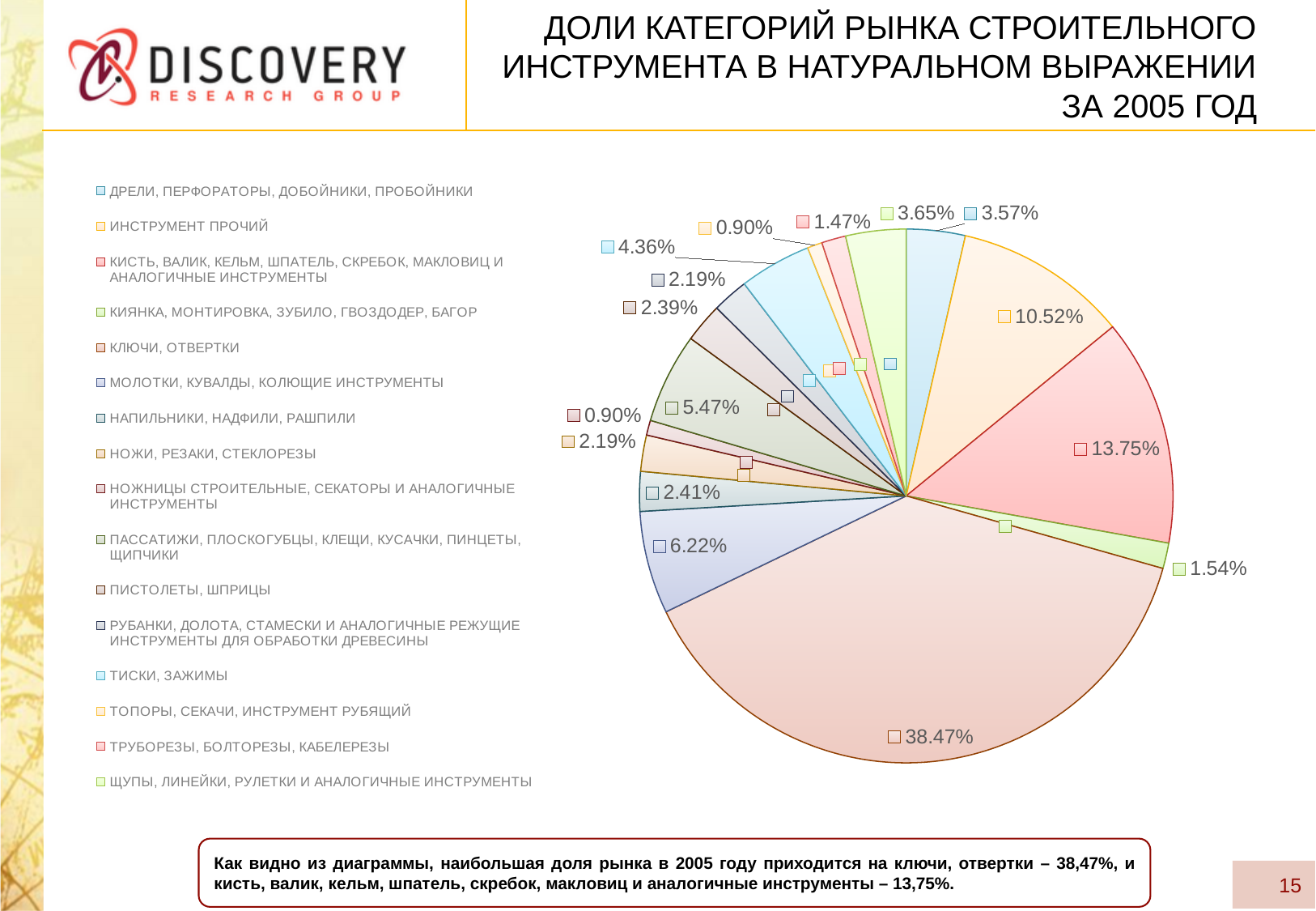
What is the share for ИНСТРУМЕНТ ПРОЧИЙ? 10.52% What is the share for КИСТЬ, ВАЛИК, КЕЛЬМ, ШПАТЕЛЬ, СКРЕБОК, МАКЛОВИЦ И АНАЛОГИЧНЫЕ ИНСТРУМЕНТЫ? 13.75% Which category has the largest share of the market in the pie chart? КЛЮЧИ, ОТВЕРТКИ What is the share for ПАССАТИЖИ, ПЛОСКОГУБЦЫ, КЛЕЩИ, КУСАЧКИ, ПИНЦЕТЫ, ЩИПЧИКИ? 5.47% What is the share for КЛЮЧИ, ОТВЕРТКИ? 38.47% What type of chart is shown on the slide? pie chart How many categories does the pie chart show? 16 By how many percentage points does the share of КЛЮЧИ, ОТВЕРТКИ exceed the share of КИСТЬ, ВАЛИК, КЕЛЬМ, ШПАТЕЛЬ, СКРЕБОК, МАКЛОВИЦ И АНАЛОГИЧНЫЕ ИНСТРУМЕНТЫ? 24.72 percentage points What is the share for МОЛОТКИ, КУВАЛДЫ, КОЛЮЩИЕ ИНСТРУМЕНТЫ? 6.22% What year does the chart's title say the market shares are for? 2005 What is the smallest share value shown on the pie chart? 0.90% Which has the larger share: ИНСТРУМЕНТ ПРОЧИЙ or КИСТЬ, ВАЛИК, КЕЛЬМ, ШПАТЕЛЬ, СКРЕБОК, МАКЛОВИЦ И АНАЛОГИЧНЫЕ ИНСТРУМЕНТЫ? КИСТЬ, ВАЛИК, КЕЛЬМ, ШПАТЕЛЬ, СКРЕБОК, МАКЛОВИЦ И АНАЛОГИЧНЫЕ ИНСТРУМЕНТЫ